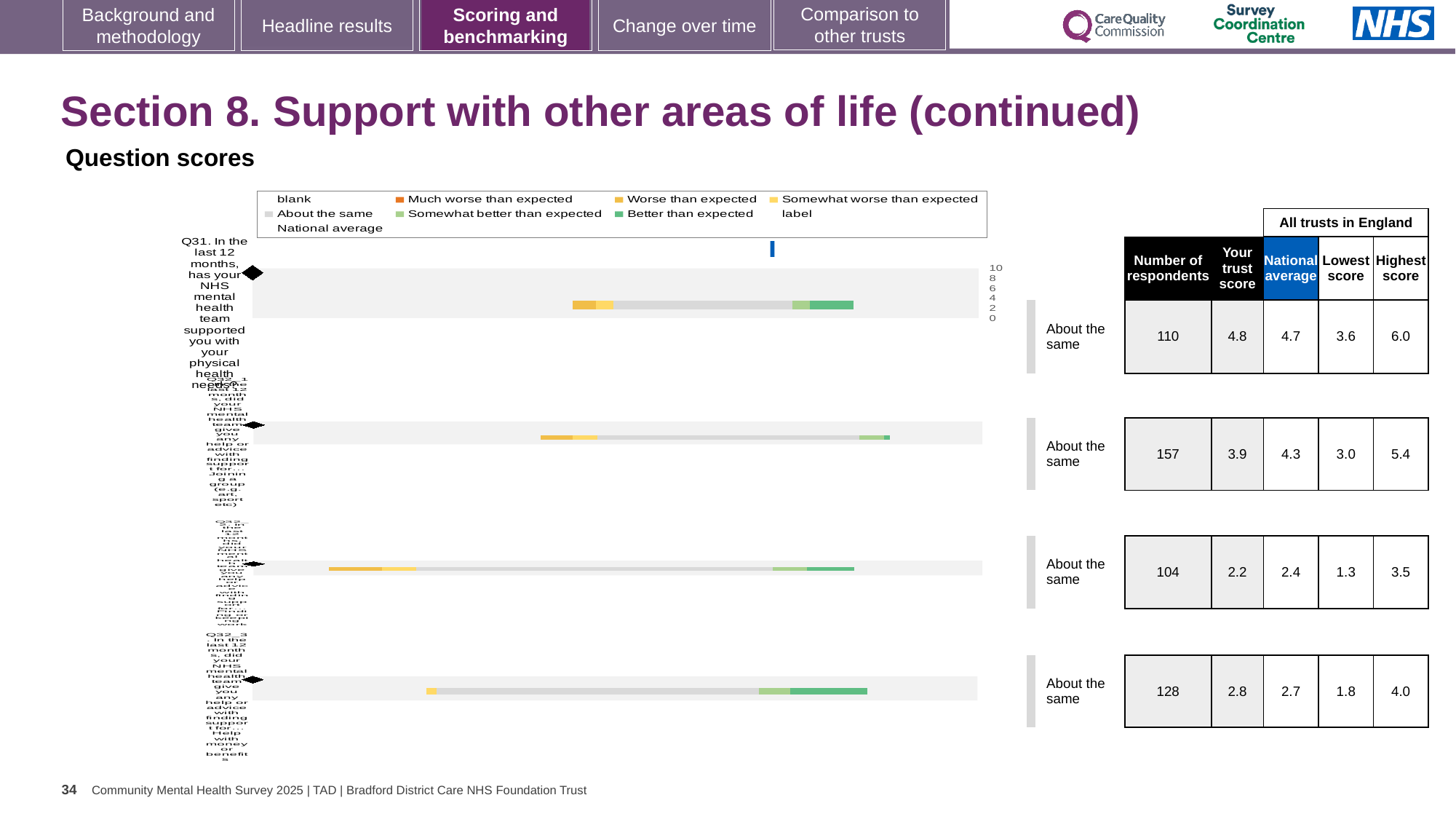
What is the national average shown for Q31? 4.7 For the second question bar from the top, which is larger: the trust score or the national average? National average What kind of chart is used to show the question scores on this slide? bar chart What is the 'Your trust score' shown for Q31? 4.8 What is the difference between the highest score and the lowest score for the third question bar from the top? 2.2 Which question bar has the highest number of respondents? The second bar from the top (157) What colour does the legend use for 'Better than expected'? Green Which question bar has the lowest 'Your trust score'? The third bar from the top (2.2) What benchmark category is shown for Q31? About the same What is the number of respondents shown for Q31 (support with physical health needs)? 110 How many question bars are plotted in the chart? 4 What is the difference between the highest score and the lowest score for Q31? 2.4